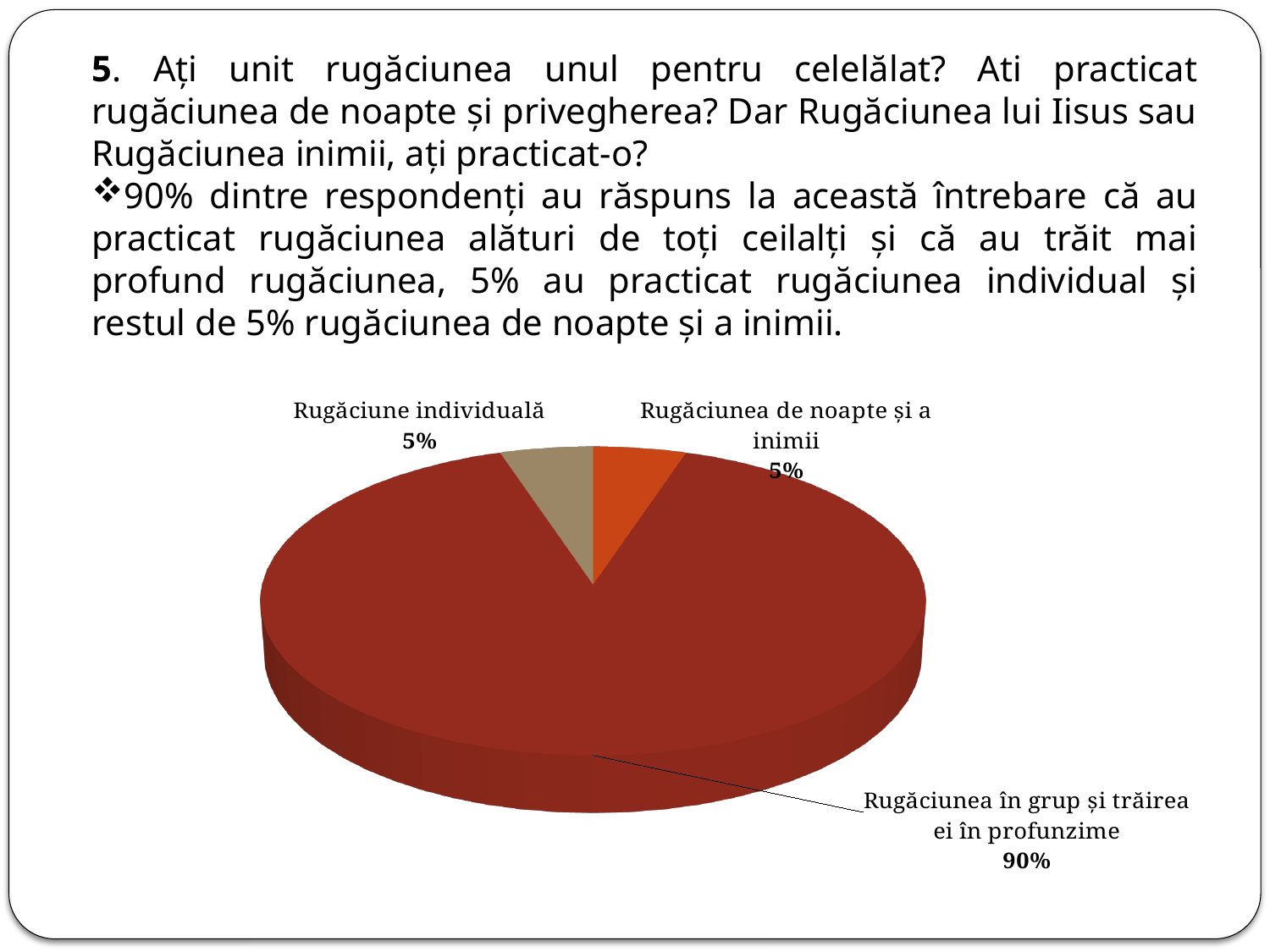
What is the combined share of "Rugăciune individuală" and "Rugăciunea de noapte și a inimii"? 10% Is the pie chart drawn in 3D? Yes What colour is the largest slice of the pie chart? Dark red What is the value shown for "Rugăciunea de noapte și a inimii"? 5% What kind of chart is shown on the slide? Pie chart Which is larger: the share for "Rugăciunea în grup și trăirea ei în profunzime" or the share for "Rugăciunea de noapte și a inimii"? Rugăciunea în grup și trăirea ei în profunzime What is the difference between the share for "Rugăciunea în grup și trăirea ei în profunzime" and the share for "Rugăciune individuală"? 85% How many slices does the pie chart have? 3 Which category has the largest slice of the pie? Rugăciunea în grup și trăirea ei în profunzime What share of the pie does "Rugăciunea în grup și trăirea ei în profunzime" represent? 90% What is the value shown for "Rugăciune individuală"? 5%